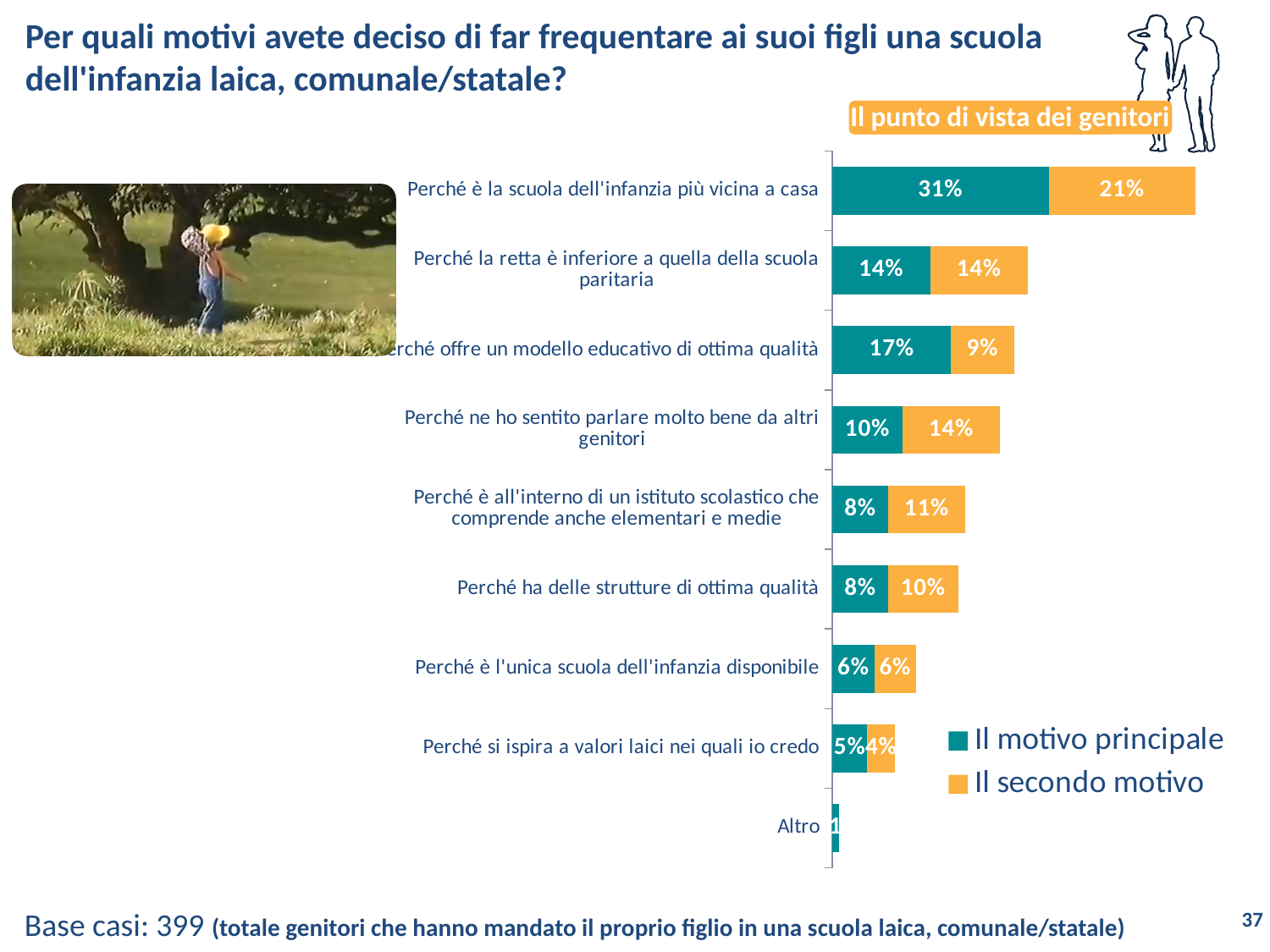
What kind of chart is shown on the slide? Stacked bar chart What is the total of the stacked bar for "Perché è la scuola dell'infanzia più vicina a casa"? 52% Which series is shown in orange in the legend? Il secondo motivo What is the difference between "Il motivo principale" and "Il secondo motivo" for "Perché è la scuola dell'infanzia più vicina a casa"? 10% For "Il motivo principale", which is larger: "Perché offre un modello educativo di ottima qualità" or "Perché la retta è inferiore a quella della scuola paritaria"? Perché offre un modello educativo di ottima qualità What is the value of "Il motivo principale" for "Perché è la scuola dell'infanzia più vicina a casa"? 31% Which category has the lowest value for "Il motivo principale"? Altro Which category has the highest value for "Il motivo principale"? Perché è la scuola dell'infanzia più vicina a casa How many series does the legend list? 2 What is the value of "Il secondo motivo" for "Perché ne ho sentito parlare molto bene da altri genitori"? 14% How many categories are shown in the chart? 9 What is the value of "Il motivo principale" for "Perché offre un modello educativo di ottima qualità"? 17%